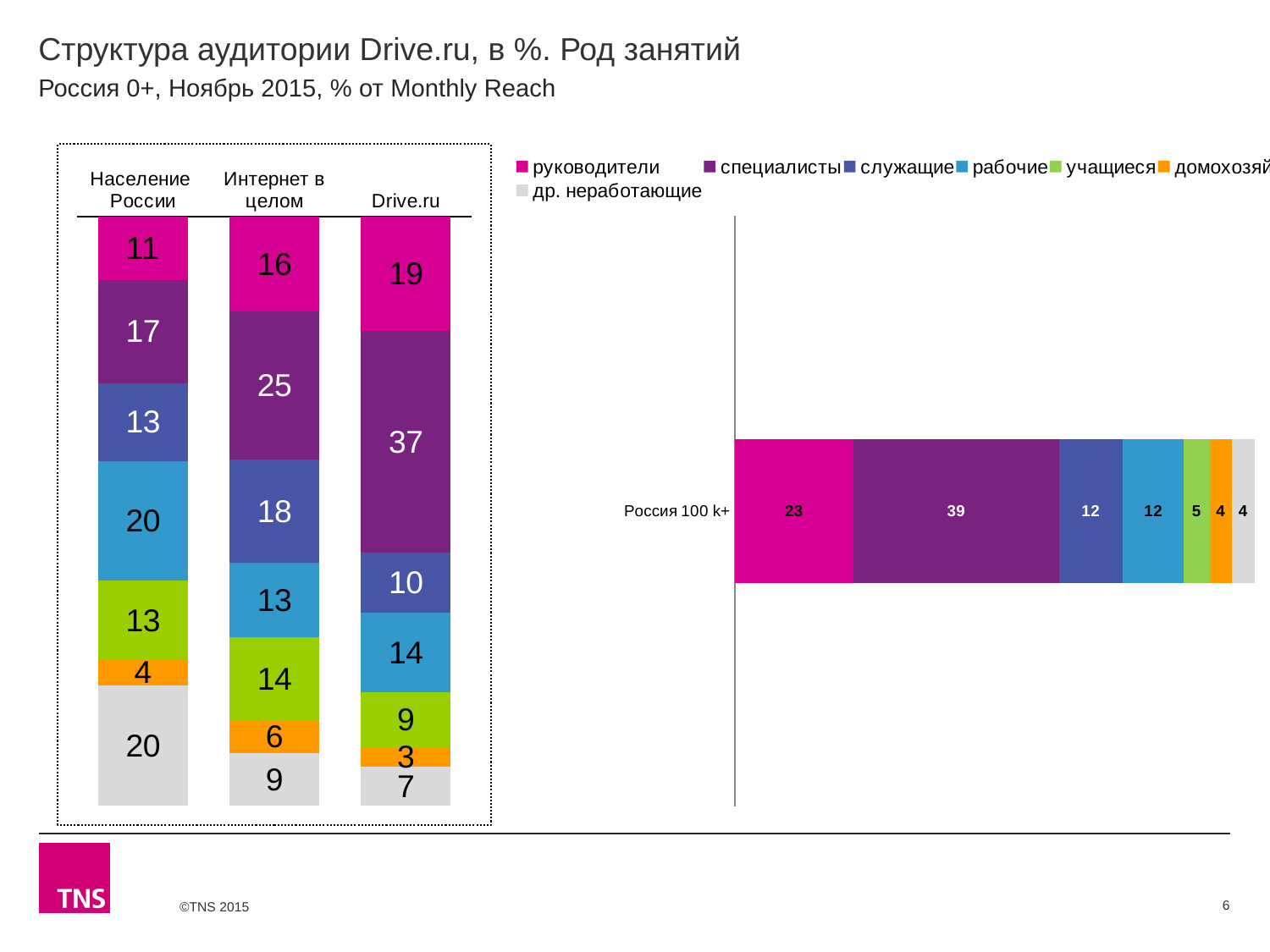
In the left chart, what is the value of the рабочие (light blue) segment for Интернет в целом? 13 In the right chart, what is the value of the руководители (pink) segment for Россия 100 k+? 23 In the left chart, what is the value of the руководители (pink) segment for Население России? 11 In the left chart, what is the value of the специалисты (purple) segment for Drive.ru? 37 How many bars does the left chart show? 3 What type of chart is the right chart? Stacked bar chart How many series does the legend on the right list? 7 In the left chart, which of the three bars has the smallest др. неработающие (grey) segment? Drive.ru In the left chart, what is the difference between the специалисты (purple) values for Drive.ru and Население России? 26 In the right chart, what is the value of the специалисты (purple) segment for Россия 100 k+? 39 In the left chart, is the учащиеся (green) segment larger for Население России or for Drive.ru? Население России In the left chart, which of the three bars has the largest специалисты (purple) segment? Drive.ru